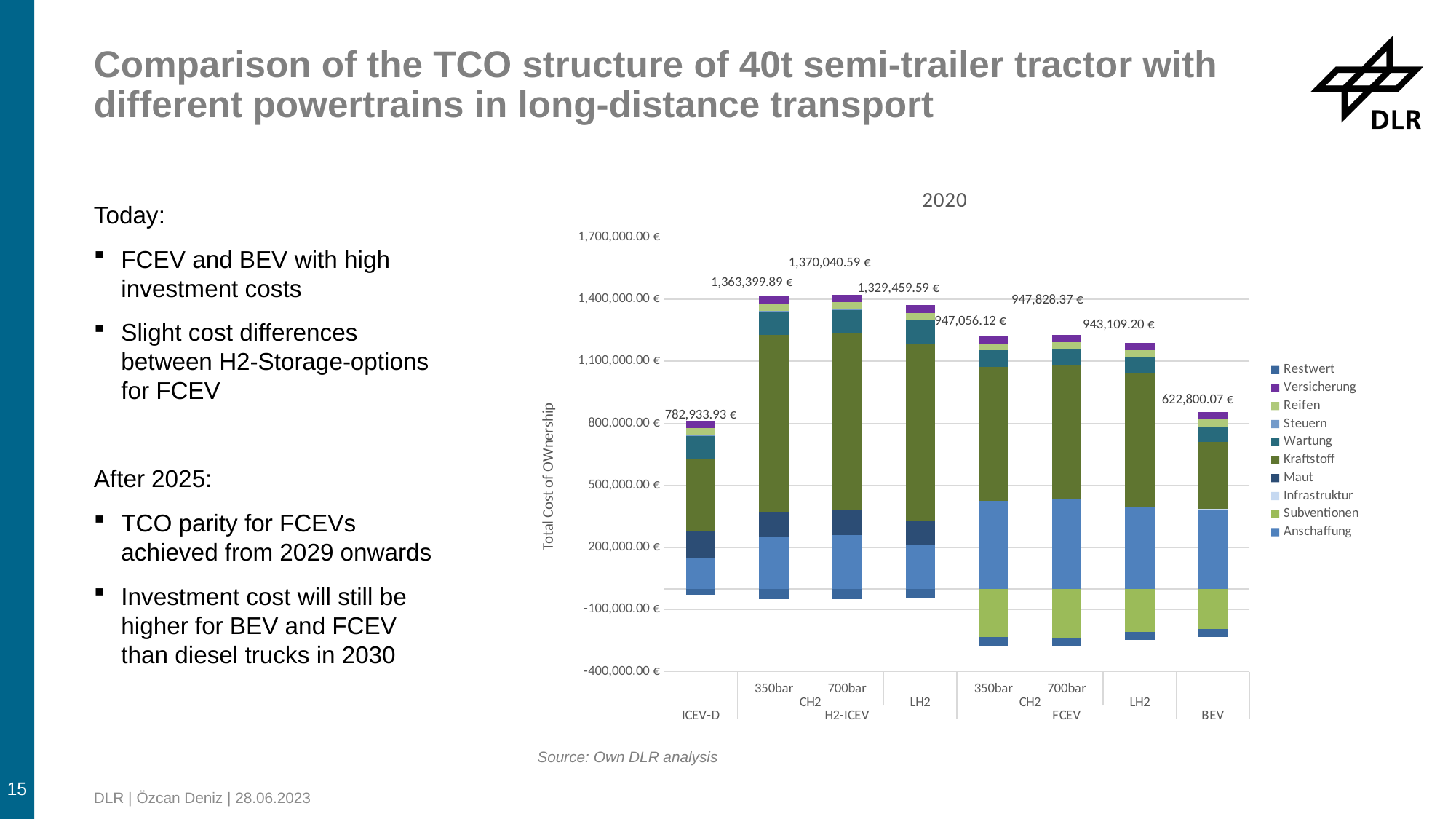
What kind of chart is shown on the slide? Stacked bar chart What is the total TCO value labelled for the ICEV-D bar? 782,933.93 € Which has the larger labelled total TCO: FCEV 350bar CH2 or FCEV 700bar CH2? FCEV 700bar CH2 What is the total TCO value labelled for the H2-ICEV LH2 bar? 1,329,459.59 € What is the difference between the labelled totals for H2-ICEV 700bar CH2 and H2-ICEV 350bar CH2? 6,640.70 € Which powertrain option has the highest labelled total TCO? H2-ICEV 700bar CH2 What is the total TCO value labelled for the BEV bar? 622,800.07 € How many series does the legend list? 10 What is the total TCO value labelled for the FCEV LH2 bar? 943,109.20 € What is the difference between the labelled totals for ICEV-D and BEV? 160,133.86 € Which powertrain option has the lowest labelled total TCO? BEV How many bars (powertrain options) are shown in the chart? 8